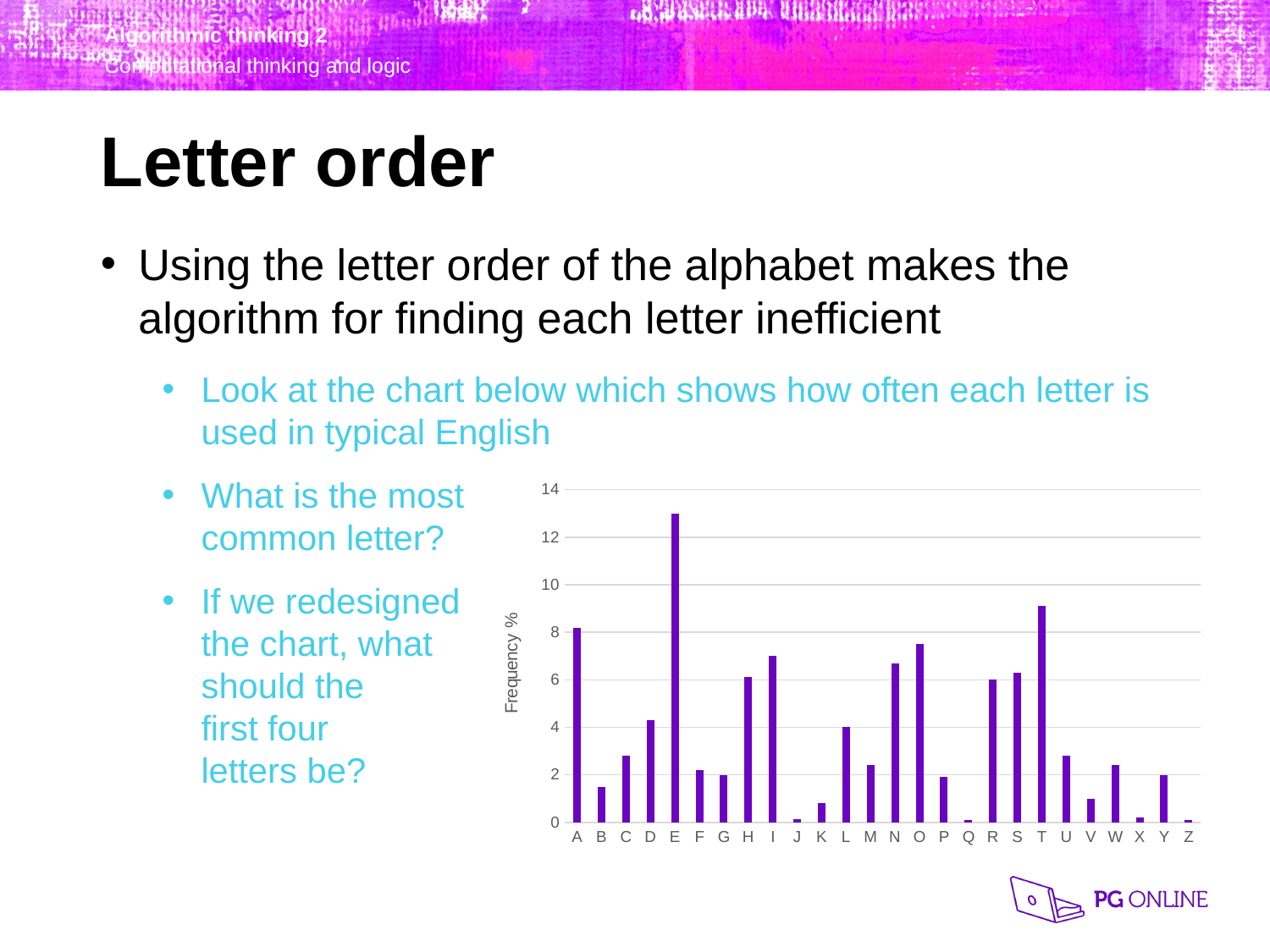
What kind of chart is shown on the slide? bar chart Is the value for T greater or less than 8? greater Which letter has the higher frequency, E or T? E Is the value for E greater or less than 12? greater Is the value for C greater or less than 4? less Which letter has the higher frequency, H or I? I What is the label on the y axis of the chart? Frequency % Which letter has the highest frequency in the chart? E How many letters (categories) are plotted on the x axis of the chart? 26